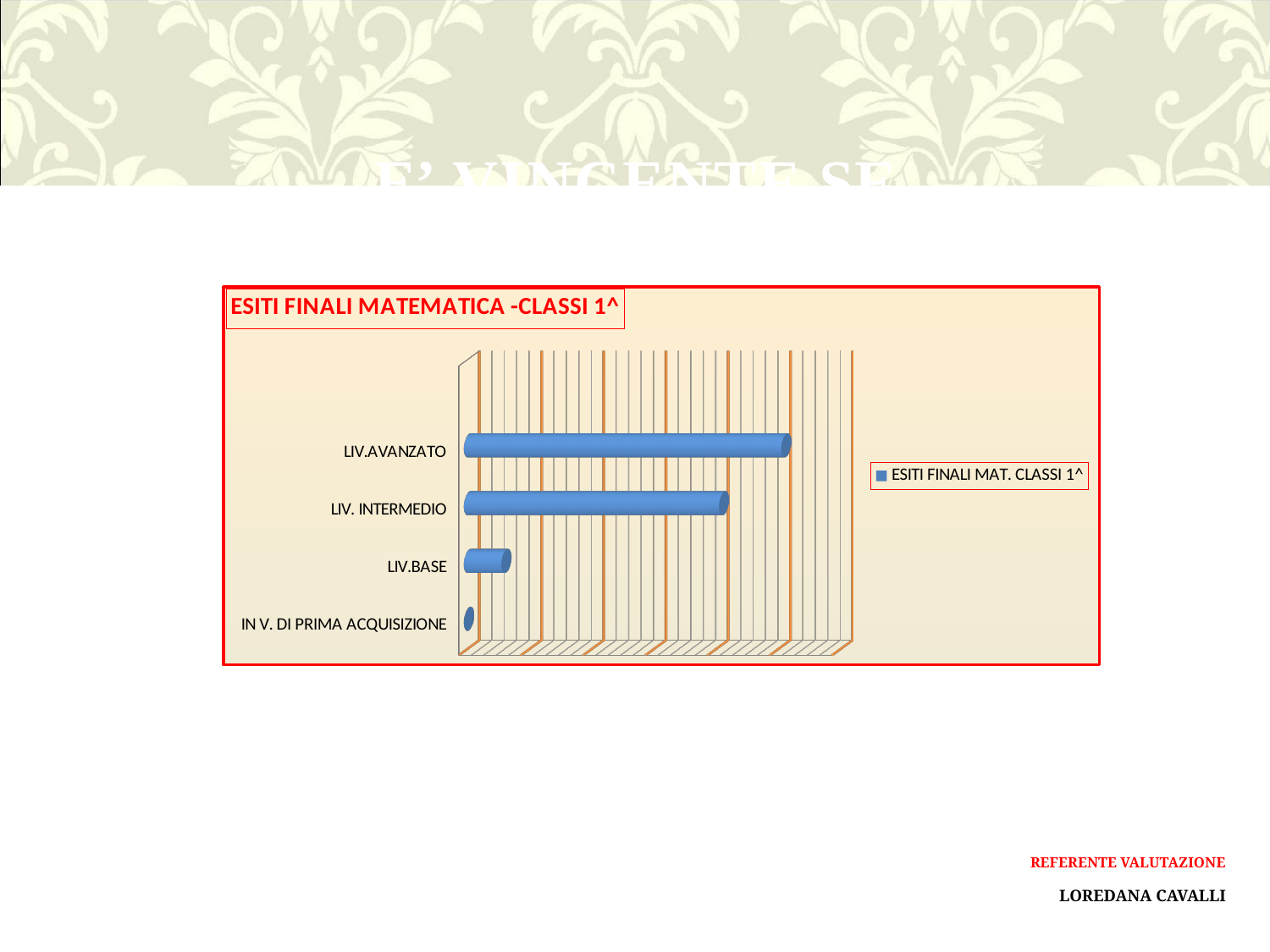
What is the title of the chart? ESITI FINALI MATEMATICA -CLASSI 1^ Which category has the highest value? LIV.AVANZATO What kind of chart is shown on the slide? bar chart Which category has the lowest value? IN V. DI PRIMA ACQUISIZIONE Do the bar values increase or decrease going from LIV.AVANZATO at the top down to IN V. DI PRIMA ACQUISIZIONE at the bottom? decrease What is the name of the series shown in the legend? ESITI FINALI MAT. CLASSI 1^ How many categories are plotted on the chart? 4 How many series does the legend list? 1 Which is larger, the value for LIV.BASE or the value for IN V. DI PRIMA ACQUISIZIONE? LIV.BASE Which is larger, the value for LIV. INTERMEDIO or the value for LIV.BASE? LIV. INTERMEDIO Which is larger, the value for LIV.AVANZATO or the value for LIV. INTERMEDIO? LIV.AVANZATO